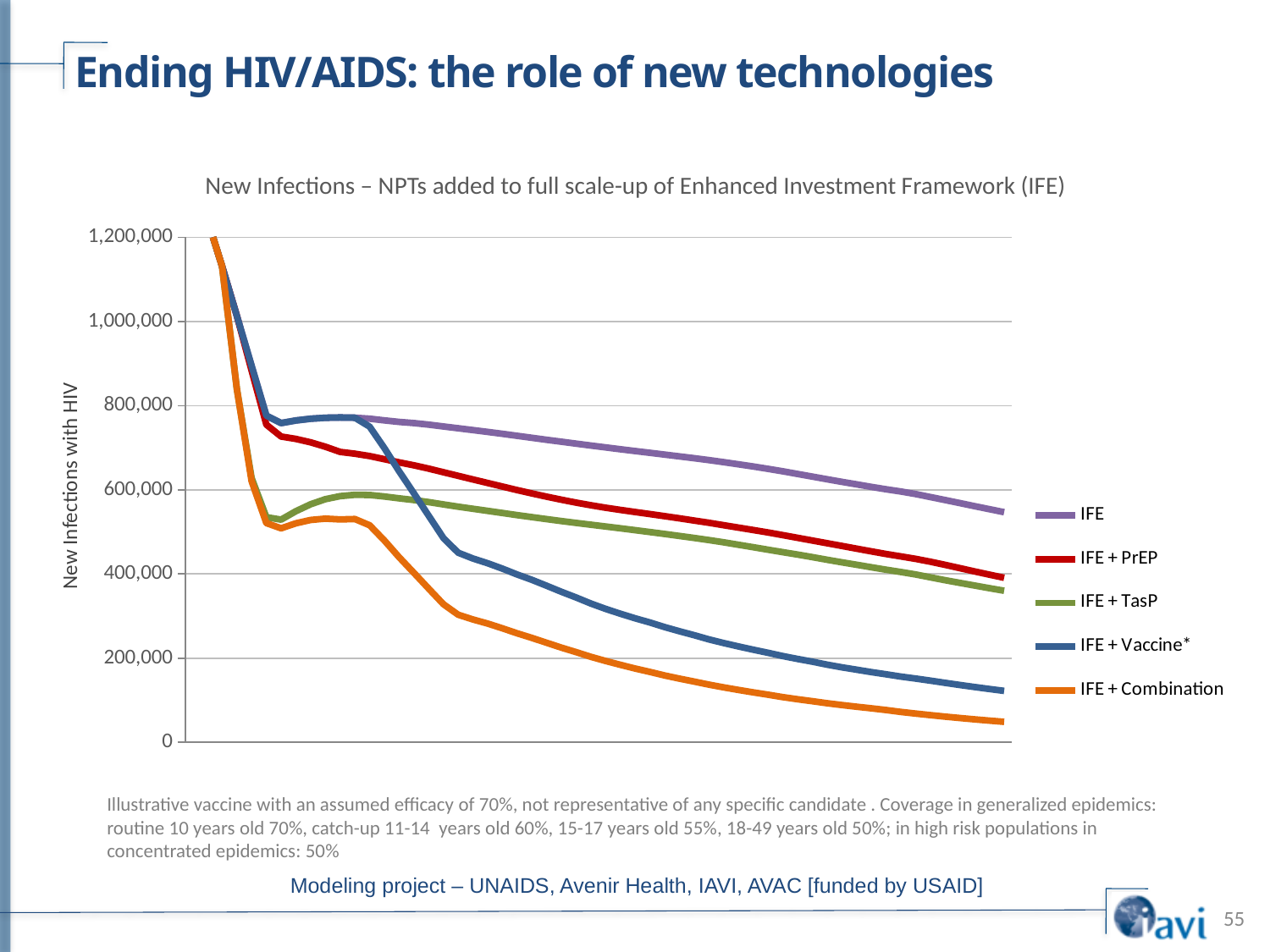
Is the value for IFE + Combination at the right end of the chart greater or less than 200,000? less Which series has the lowest value at the right end of the chart? IFE + Combination Is the value for IFE at the right end of the chart greater or less than 400,000? greater What is the label on the vertical axis? New Infections with HIV Which series has the highest value at the right end of the chart? IFE What is the title of the chart? New Infections – NPTs added to full scale-up of Enhanced Investment Framework (IFE) At the right end of the chart, which is larger: IFE + TasP or IFE + Combination? IFE + TasP What kind of chart is shown on the slide? line chart How many series does the legend list? 5 Is the value for IFE + Vaccine* at the right end of the chart greater or less than 200,000? less Do the values for the IFE series rise or fall along the x axis? fall At the right end of the chart, which is larger: IFE + PrEP or IFE + Vaccine*? IFE + PrEP